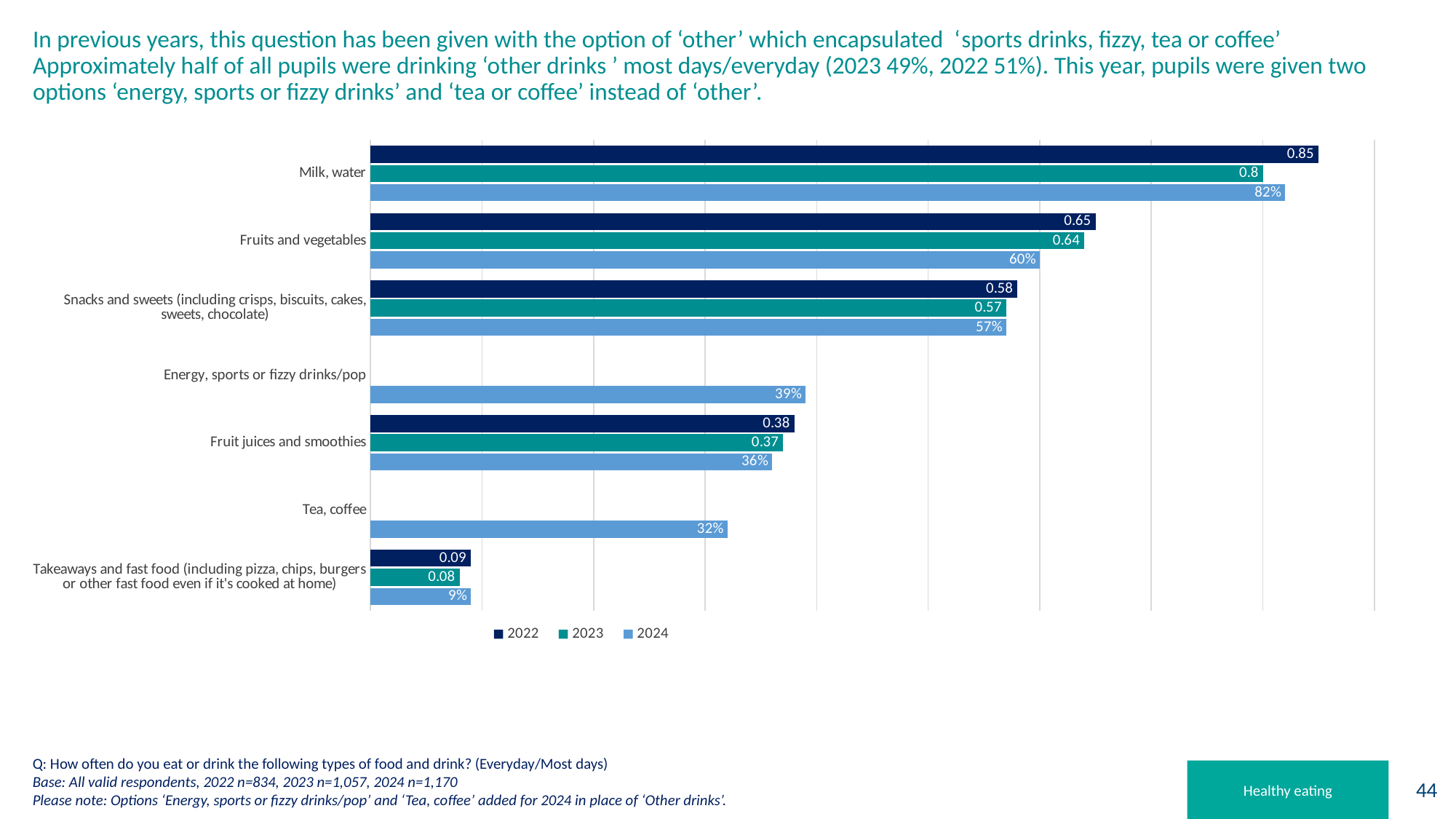
What is the 2022 value for Milk, water? 0.85 What is the difference between the 2022 values for Milk, water and Fruits and vegetables? 0.2 What kind of chart is shown on the slide? Bar chart What is the 2024 value for Energy, sports or fizzy drinks/pop? 39% What is the difference between the 2024 values for Milk, water and Takeaways and fast food? 73% How many categories are shown on the chart? 7 Which category has the lowest 2022 value? Takeaways and fast food (including pizza, chips, burgers or other fast food even if it's cooked at home) How many series does the legend list? 3 What is the 2023 value for Fruit juices and smoothies? 0.37 Which is larger: the 2024 value for Energy, sports or fizzy drinks/pop or the 2024 value for Tea, coffee? Energy, sports or fizzy drinks/pop Which category has the highest 2024 value? Milk, water What is the 2024 value for Tea, coffee? 32%